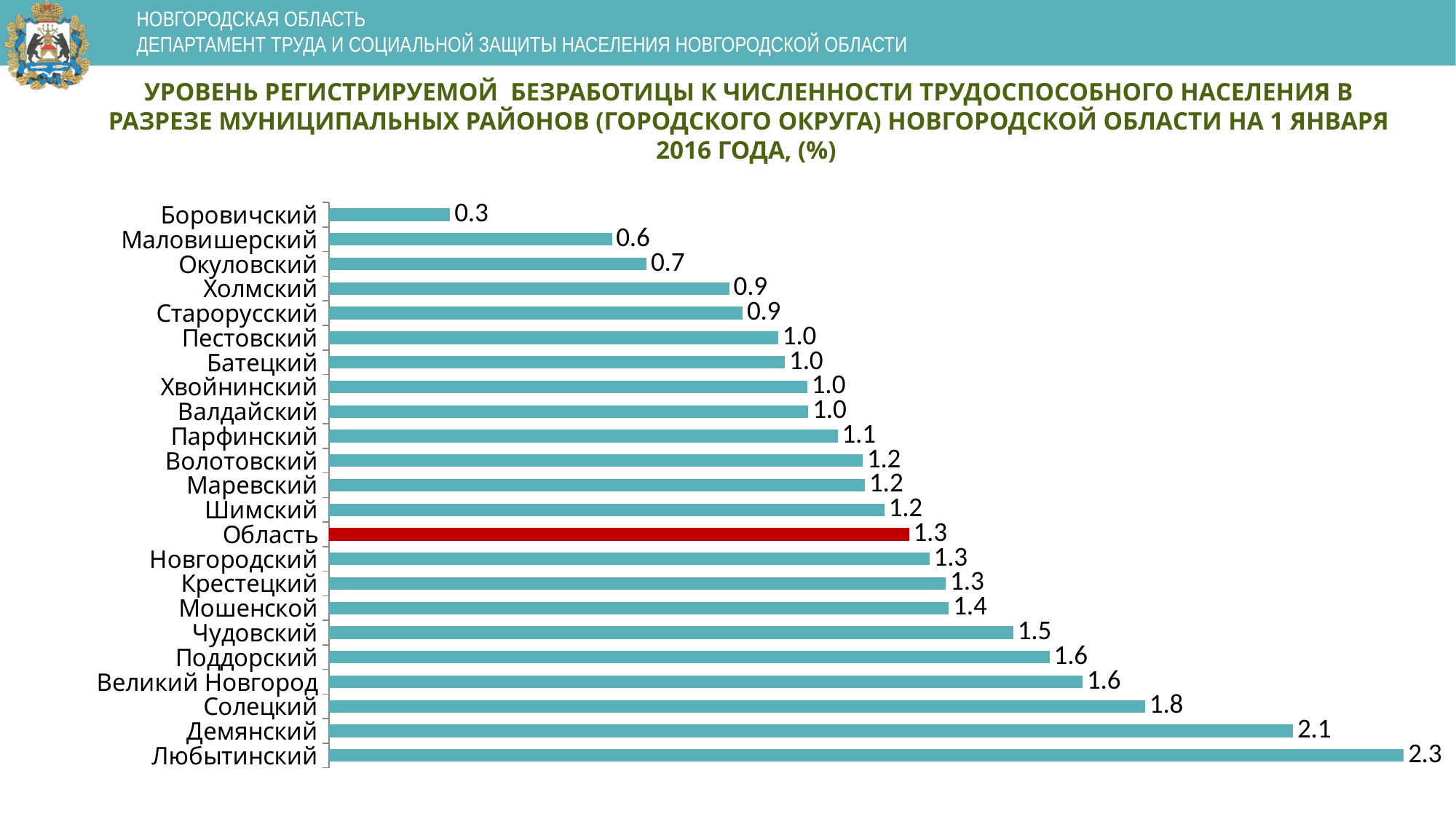
What is the difference between the values for Демянский and Солецкий? 0.3 What is the value for Боровичский? 0.3 What is the difference between the values for Любытинский and Боровичский? 2.0 Which category has the lowest value? Боровичский How many categories (bars) are shown in the chart? 23 What is the value for Любытинский? 2.3 Which is larger, the value for Чудовский or the value for Мошенской? Чудовский Which category has the highest value? Любытинский What is the value for Великий Новгород? 1.6 What is the value for Область (the red bar)? 1.3 Which bar is highlighted in red? Область What kind of chart is shown on the slide? Bar chart